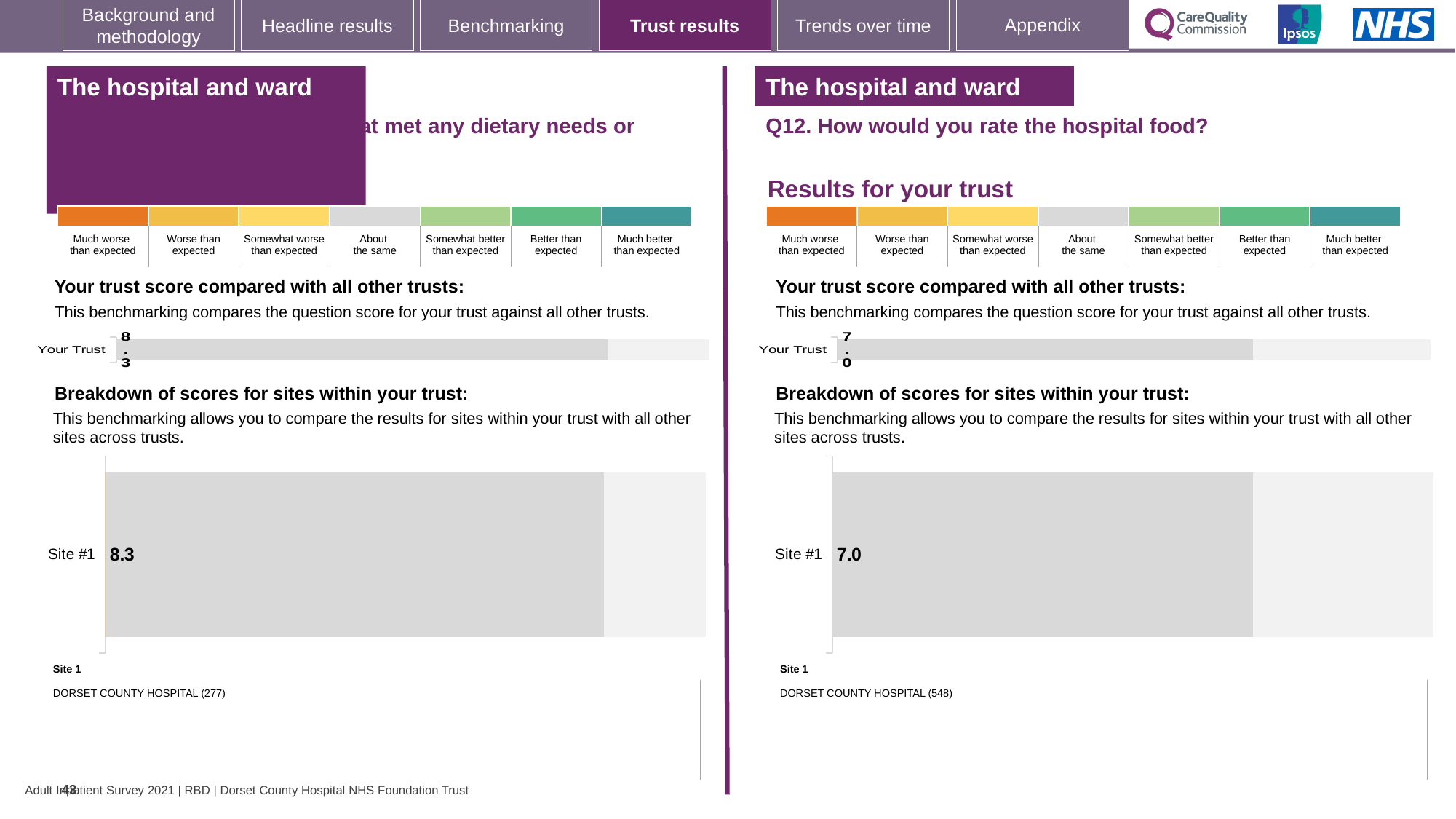
What kind of chart is used to show the Your Trust score on the left-hand panel? Bar chart On the right-hand panel (Q12), which hospital is listed as Site 1 below the breakdown chart? DORSET COUNTY HOSPITAL (548) What is the difference between the Your Trust score on the left-hand panel (8.3) and the Your Trust score on the right-hand panel (7.0)? 1.3 How many sites are shown in the breakdown of scores chart on the left-hand panel? 1 How many sites are shown in the breakdown of scores chart on the right-hand panel (Q12)? 1 On the left-hand panel, what is the score shown for Your Trust? 8.3 Which is larger: the Your Trust score on the left-hand panel or the Your Trust score on the right-hand panel (Q12)? Left-hand panel (8.3) What kind of chart is used to show the Site #1 score on the right-hand panel (Q12)? Bar chart On the right-hand panel (Q12), what is the score shown for Site #1 in the breakdown of scores for sites within your trust? 7.0 On the left-hand panel, which hospital is listed as Site 1 below the breakdown chart? DORSET COUNTY HOSPITAL (277) On the right-hand panel (Q12. How would you rate the hospital food?), what is the score shown for Your Trust? 7.0 On the left-hand panel, what is the score shown for Site #1 in the breakdown of scores for sites within your trust? 8.3